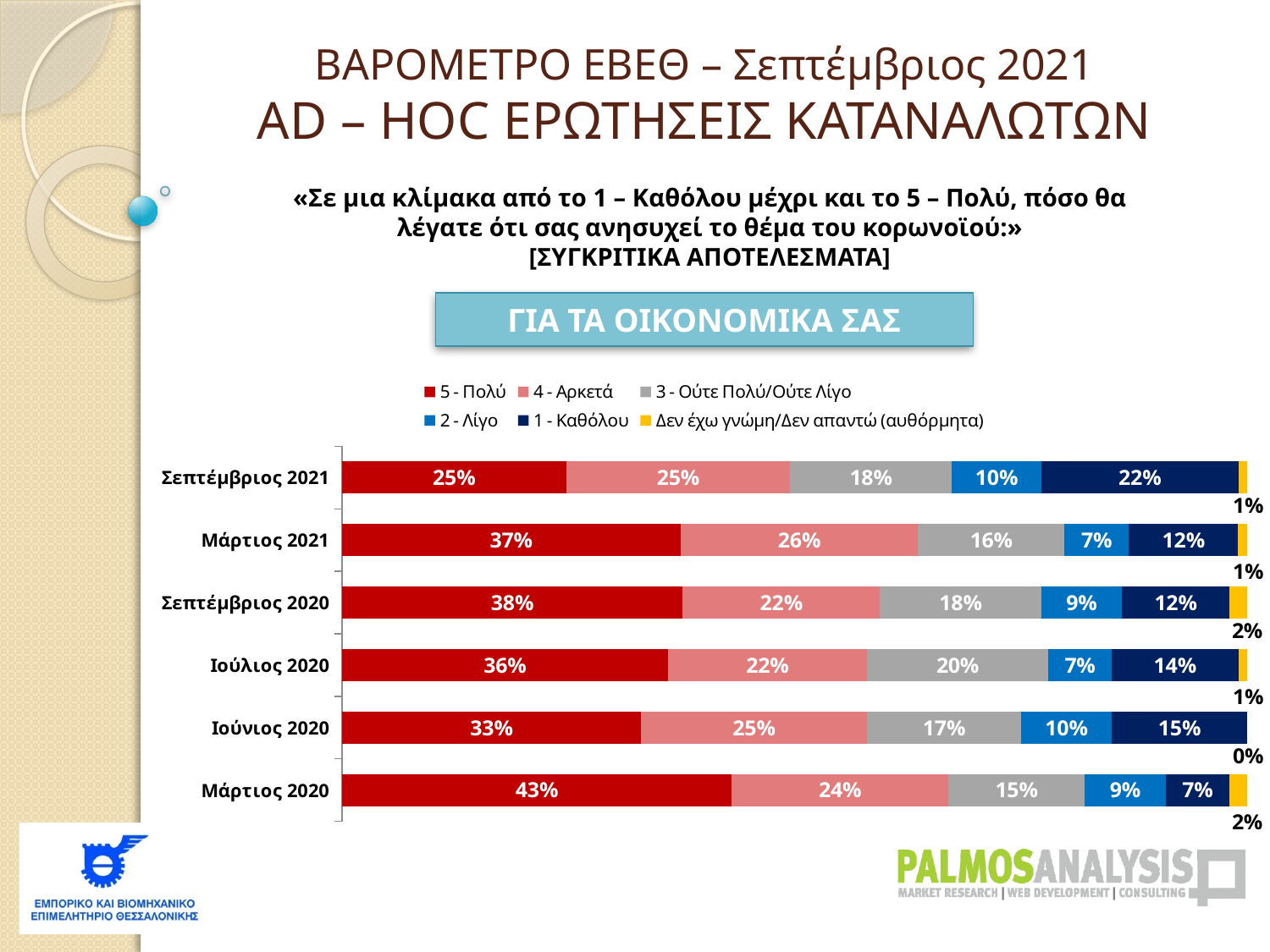
Which period has the highest value for "5 - Πολύ"? Μάρτιος 2020 What kind of chart is shown on the slide? Stacked bar chart Which period has the lowest value for "5 - Πολύ"? Σεπτέμβριος 2021 What is the title shown in the box above the chart? ΓΙΑ ΤΑ ΟΙΚΟΝΟΜΙΚΑ ΣΑΣ What is the difference between the "5 - Πολύ" values for Μάρτιος 2021 and Σεπτέμβριος 2021? 12% What is the value for "1 - Καθόλου" in Μάρτιος 2020? 7% How many series does the legend list? 6 What is the total of the "5 - Πολύ" and "4 - Αρκετά" values for Μάρτιος 2020? 67% Which is larger: the "1 - Καθόλου" value for Σεπτέμβριος 2021 or for Ιούνιος 2020? Σεπτέμβριος 2021 What percentage of respondents answered "5 - Πολύ" in Σεπτέμβριος 2021? 25% What is the value for "3 - Ούτε Πολύ/Ούτε Λίγο" in Ιούλιος 2020? 20% How many time periods are shown on the chart? 6